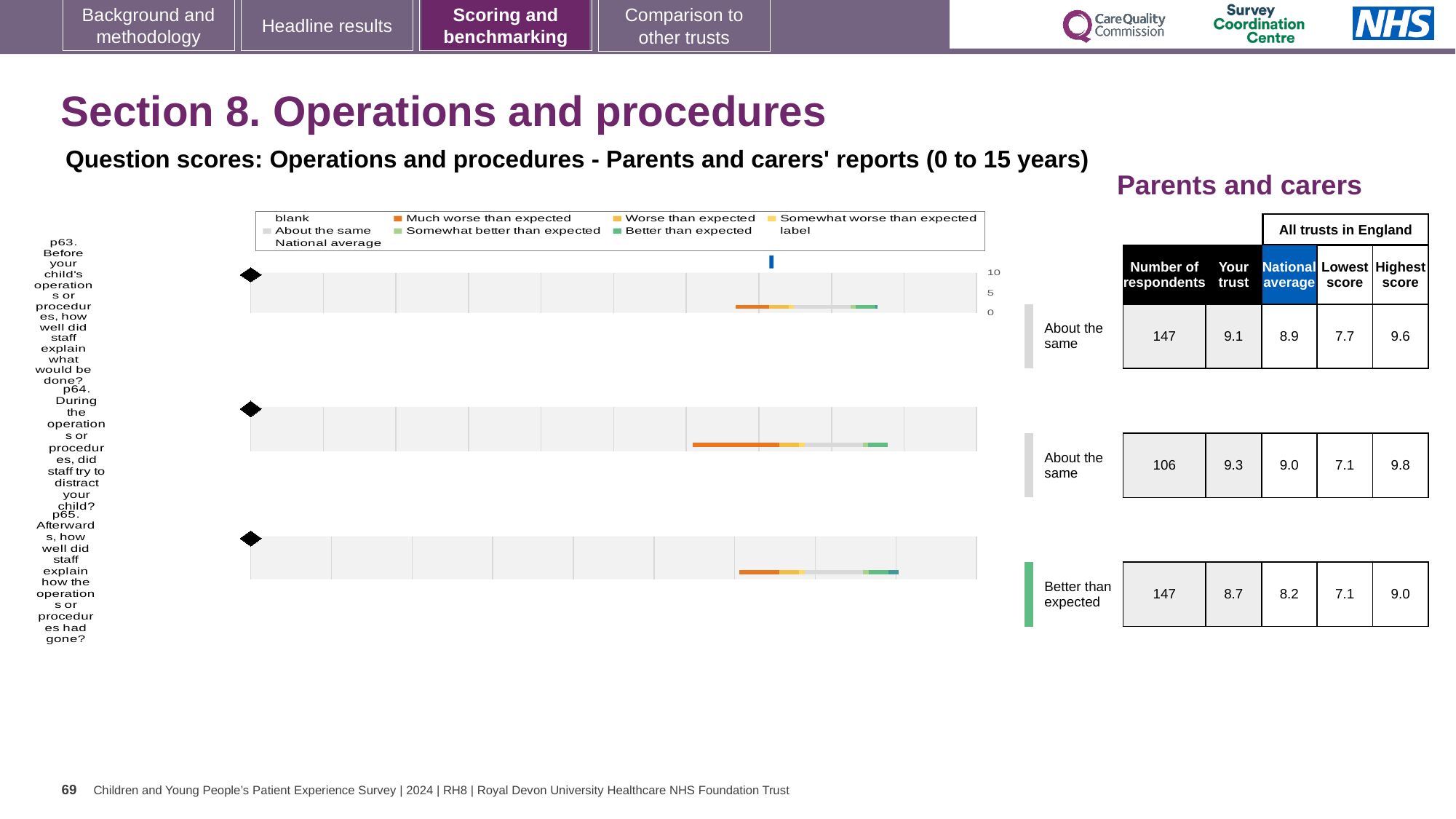
Which question has the lowest national average score on this slide? p65 How many entries does the chart legend list? 9 What is the difference between the highest score and the lowest score across all trusts in England for p64? 2.7 For p65, which is larger: the 'Your trust' score or the national average? Your trust How many questions (chart rows) are shown on this slide? 3 Which question has the highest 'Your trust' score on this slide? p64 What is the national average score for p64 (During the operations or procedures, did staff try to distract your child?)? 9.0 What is the difference between the 'Your trust' score and the national average for p63? 0.2 What is the 'Your trust' score for p63 (Before your child's operations or procedures, how well did staff explain what would be done?)? 9.1 How many respondents answered p65 (Afterwards, how well did staff explain how the operations or procedures had gone?)? 147 What kind of chart is used to show the question scores on this slide? Bar chart What benchmark category is shown for p65 (Afterwards, how well did staff explain how the operations or procedures had gone?)? Better than expected